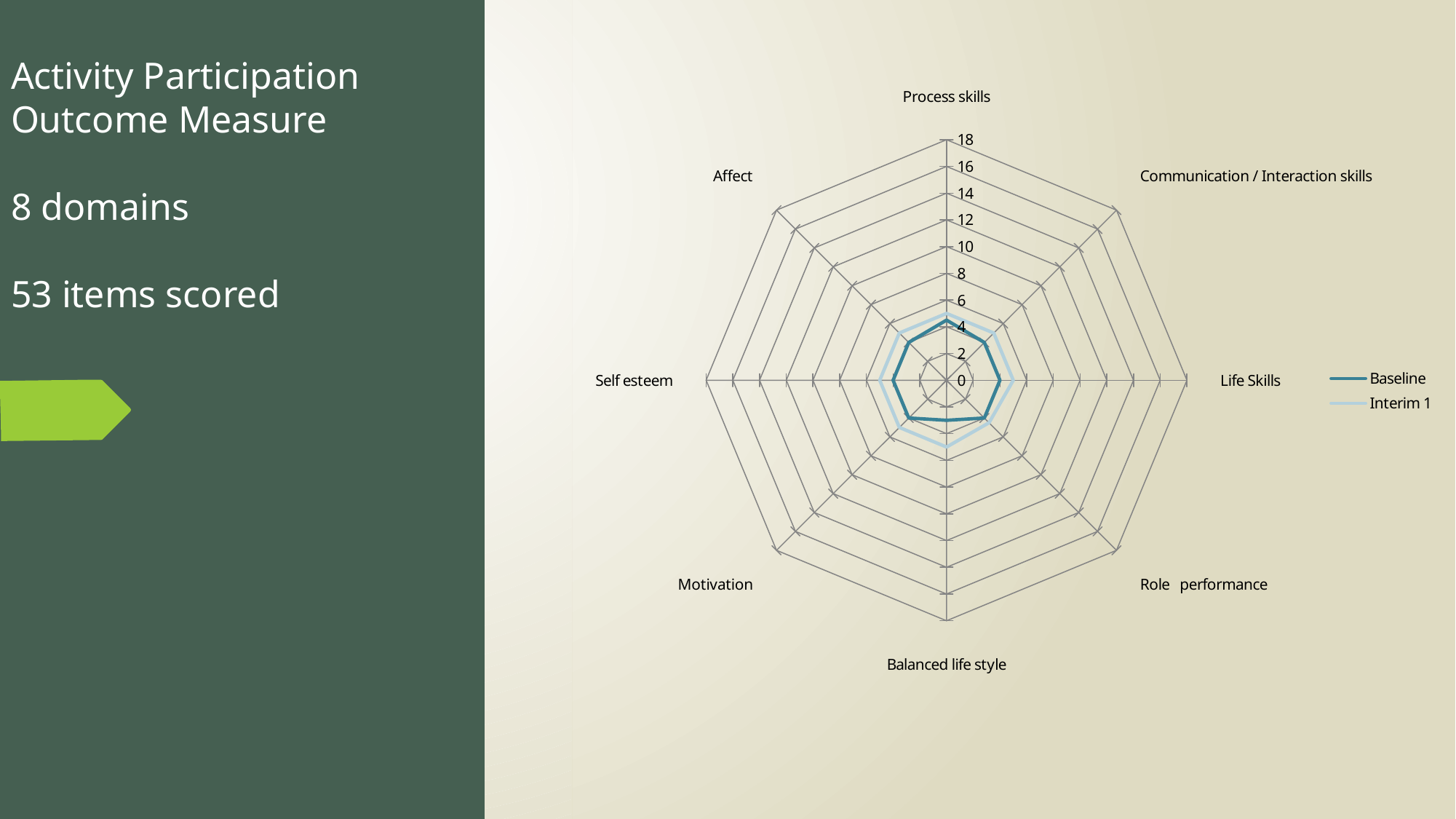
For Communication / Interaction skills, which series has the larger value, Baseline or Interim 1? Interim 1 For Motivation, which series has the larger value, Baseline or Interim 1? Interim 1 Is the Baseline value for Role performance greater or less than 12? less What is the maximum value shown on the radar chart's axis? 18 How many series does the legend list? 2 Is the Baseline value for Process skills greater or less than 8? less What are the two series named in the legend? Baseline and Interim 1 Is the Interim 1 value for Balanced life style greater or less than 10? less How many categories (domains) does the radar chart plot? 8 What kind of chart is shown on the slide? radar chart